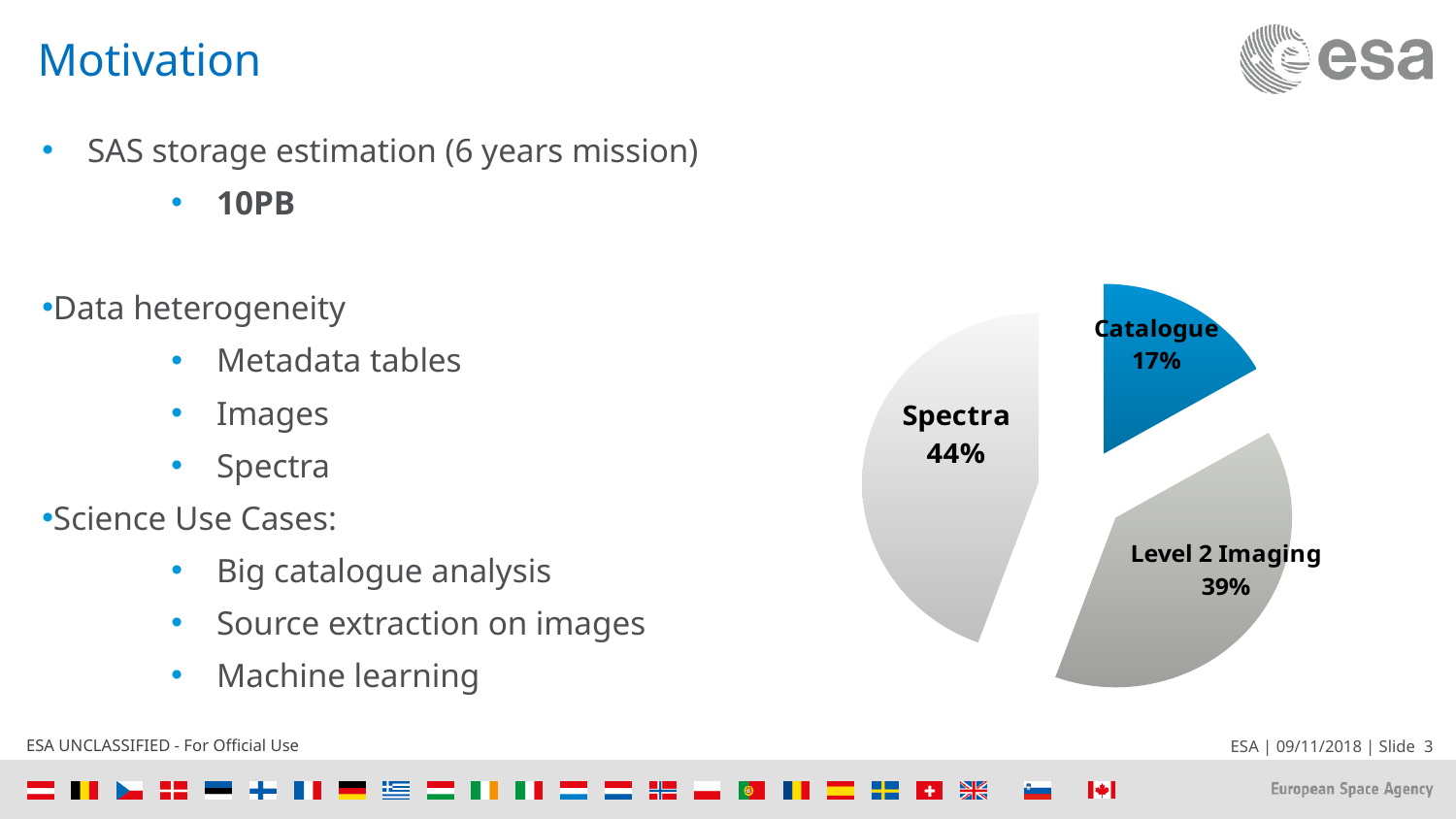
What is the difference in percentage points between Level 2 Imaging and Catalogue? 22 Which slice of the pie chart is the largest? Spectra What kind of chart is shown on the slide? pie chart What is the difference in percentage points between Spectra and Level 2 Imaging? 5 Which is larger, the Spectra slice or the Catalogue slice? Spectra Which is larger, the Catalogue slice or the Level 2 Imaging slice? Level 2 Imaging Which slice of the pie chart is the smallest? Catalogue Which slice of the pie chart is coloured blue? Catalogue How many slices does the pie chart have? 3 What share of the pie does Level 2 Imaging represent? 39% What share of the pie does Catalogue represent? 17% What share of the pie does Spectra represent? 44%